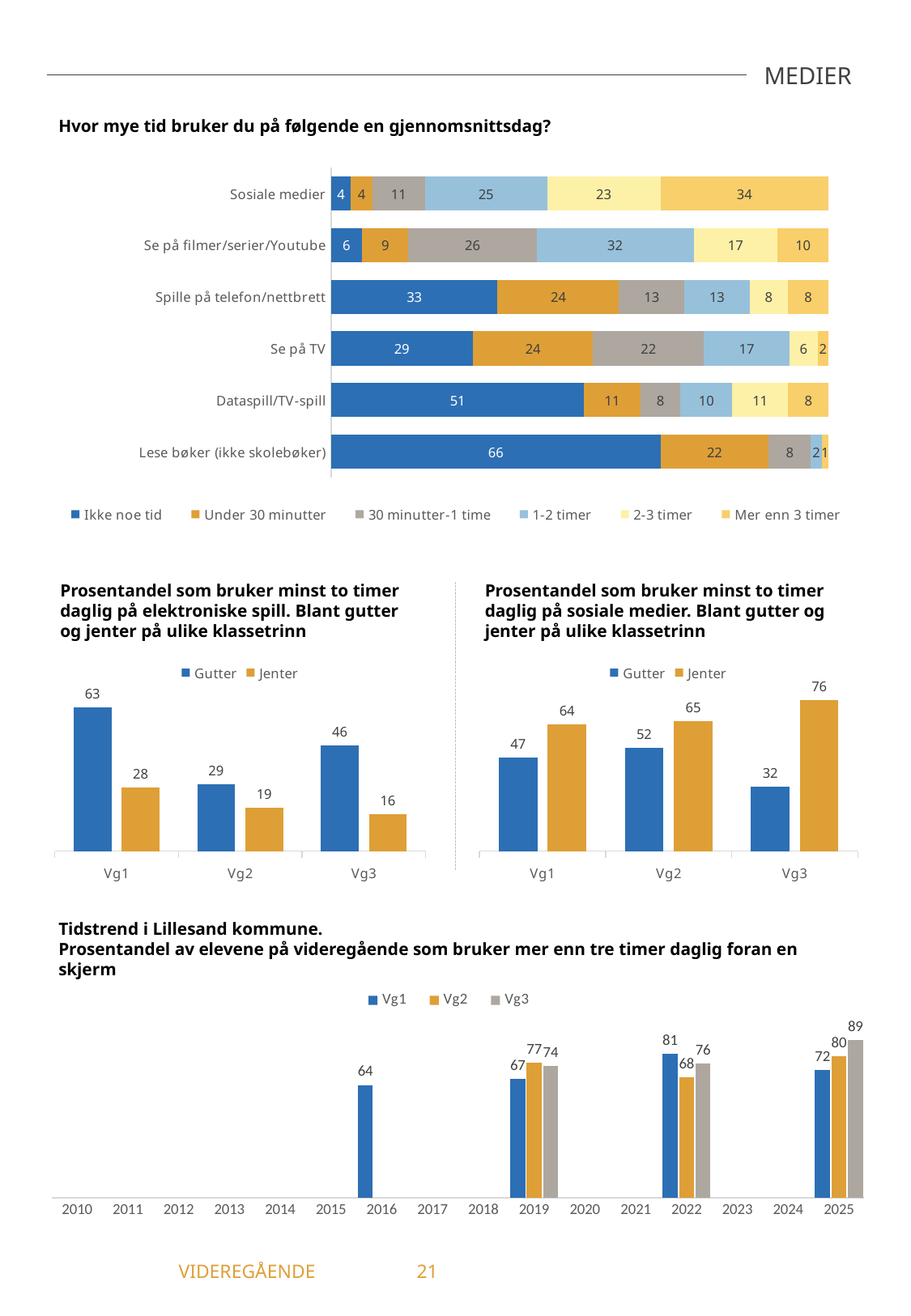
In the chart 'Prosentandel som bruker minst to timer daglig på sosiale medier', what is the difference between Jenter and Gutter at Vg1? 17 In the chart 'Hvor mye tid bruker du på følgende en gjennomsnittsdag?', what is the difference between the 'Ikke noe tid' values for Dataspill/TV-spill and Se på TV? 22 In the chart 'Prosentandel som bruker minst to timer daglig på sosiale medier', which is larger at Vg2: Gutter or Jenter? Jenter In the chart 'Prosentandel som bruker minst to timer daglig på elektroniske spill', what is the value for Gutter at Vg1? 63 In the chart 'Hvor mye tid bruker du på følgende en gjennomsnittsdag?', which category has the highest value for 'Ikke noe tid'? Lese bøker (ikke skolebøker) In the chart 'Prosentandel som bruker minst to timer daglig på elektroniske spill', which class level has the lowest value for Jenter? Vg3 In the chart 'Tidstrend i Lillesand kommune', what is the value for Vg3 in 2025? 89 In the chart 'Prosentandel som bruker minst to timer daglig på sosiale medier', what is the value for Jenter at Vg3? 76 In the chart 'Hvor mye tid bruker du på følgende en gjennomsnittsdag?', how many series does the legend list? 6 In the chart 'Tidstrend i Lillesand kommune', what kind of chart is shown? Bar chart In the chart 'Hvor mye tid bruker du på følgende en gjennomsnittsdag?', what is the value for 'Mer enn 3 timer' for Sosiale medier? 34 In the chart 'Tidstrend i Lillesand kommune', does the value for Vg3 rise or fall from 2019 to 2025? Rise